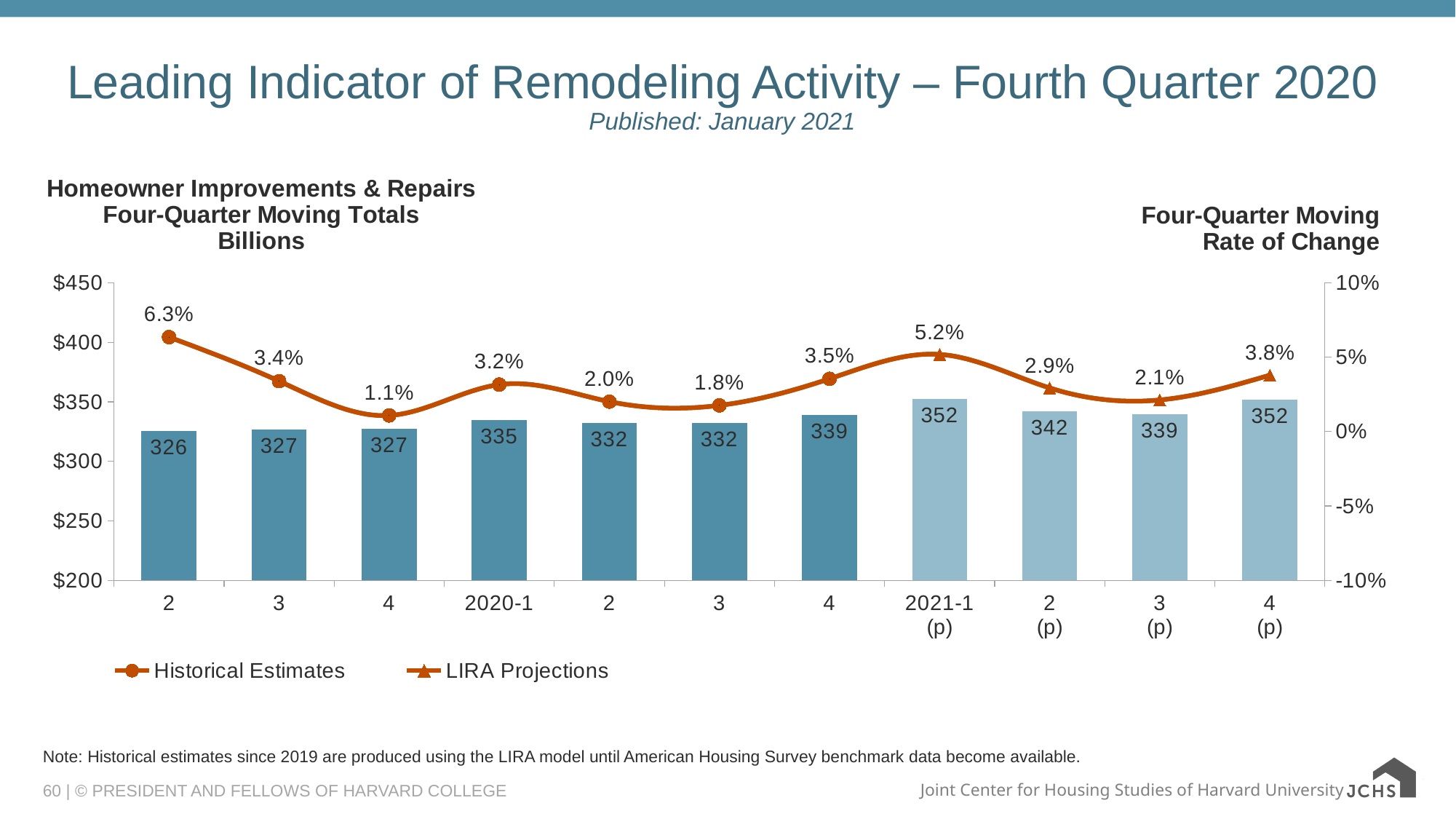
What is the difference between the four-quarter moving total for 2021-1 (p) and for 2020-1? 17 Is the four-quarter moving total larger for 2020-4 or for 2021-2 (p)? 2021-2 (p) What is the four-quarter moving rate of change for the first category, quarter 2 (of 2019)? 6.3% What is the four-quarter moving rate of change for 2021-1 (p)? 5.2% What are the two entries listed in the legend? Historical Estimates and LIRA Projections What kind of chart is this? Combination bar and line chart Which category has the lowest four-quarter moving rate of change? 4 (2019) Does the four-quarter moving rate of change rise or fall from 2020-1 to 2020-3? Fall How many quarters (categories) are shown on the x axis? 11 How many series does the legend list? 2 Which category has the highest four-quarter moving rate of change? 2 (2019) What is the four-quarter moving total (in billions) for 2020-1? 335